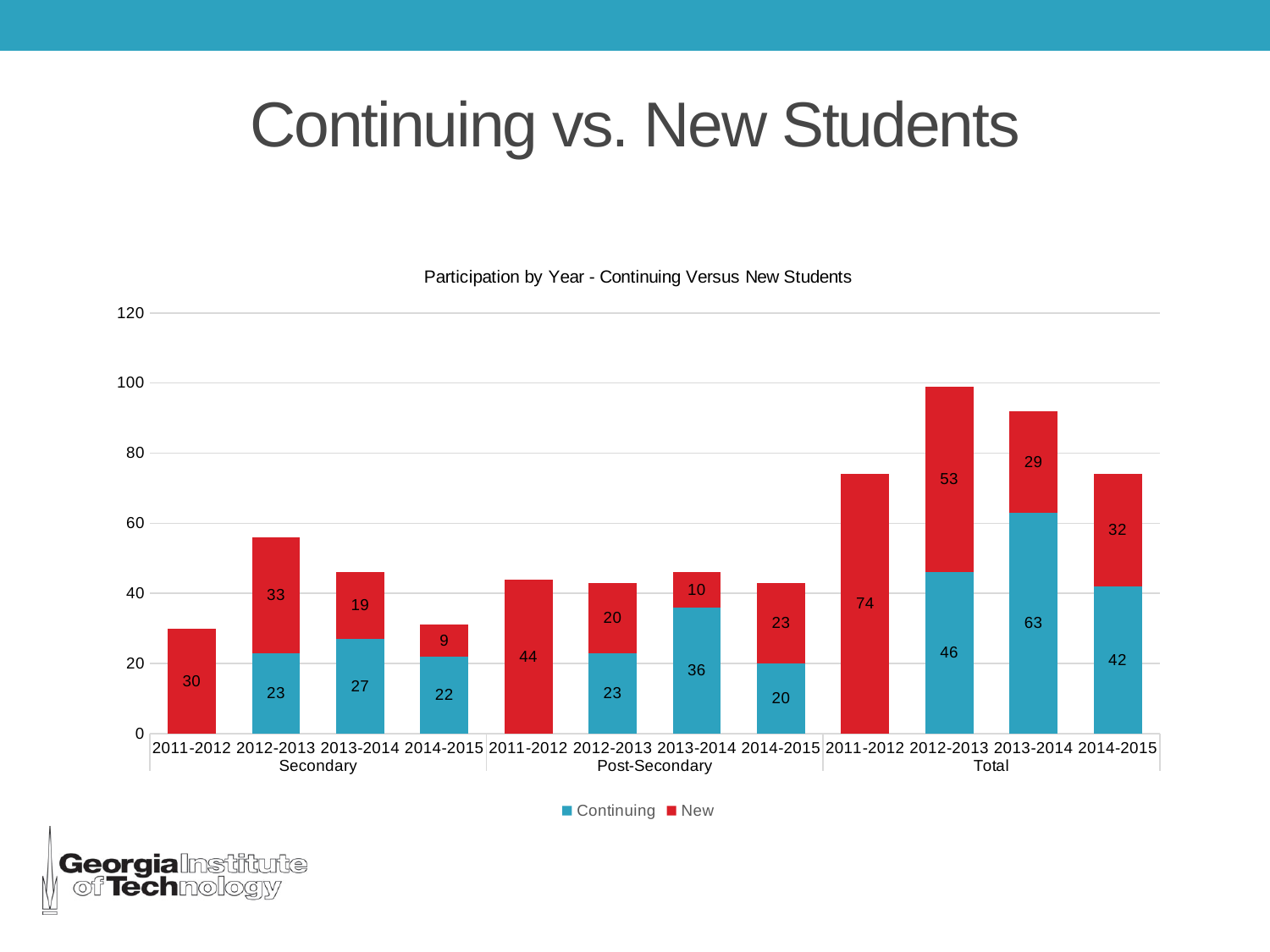
How many series does the legend list? 2 What kind of chart is shown on the slide? Stacked bar chart What is the title of the chart? Participation by Year - Continuing Versus New Students What is the total of the stacked bar for Total 2012-2013? 99 Which year in the Total group has the highest Continuing value? 2013-2014 What is the value for Continuing students in the Post-Secondary 2013-2014 bar? 36 What is the difference between the New values for Total 2012-2013 and Total 2013-2014? 24 Which is larger: the Continuing value for Post-Secondary 2012-2013 or the Continuing value for Post-Secondary 2013-2014? Post-Secondary 2013-2014 What is the value for New students in the Secondary 2012-2013 bar? 33 What is the total of the stacked bar for Secondary 2014-2015? 31 Which year in the Secondary group has the lowest New value? 2014-2015 What is the value for Continuing students in the Total 2013-2014 bar? 63